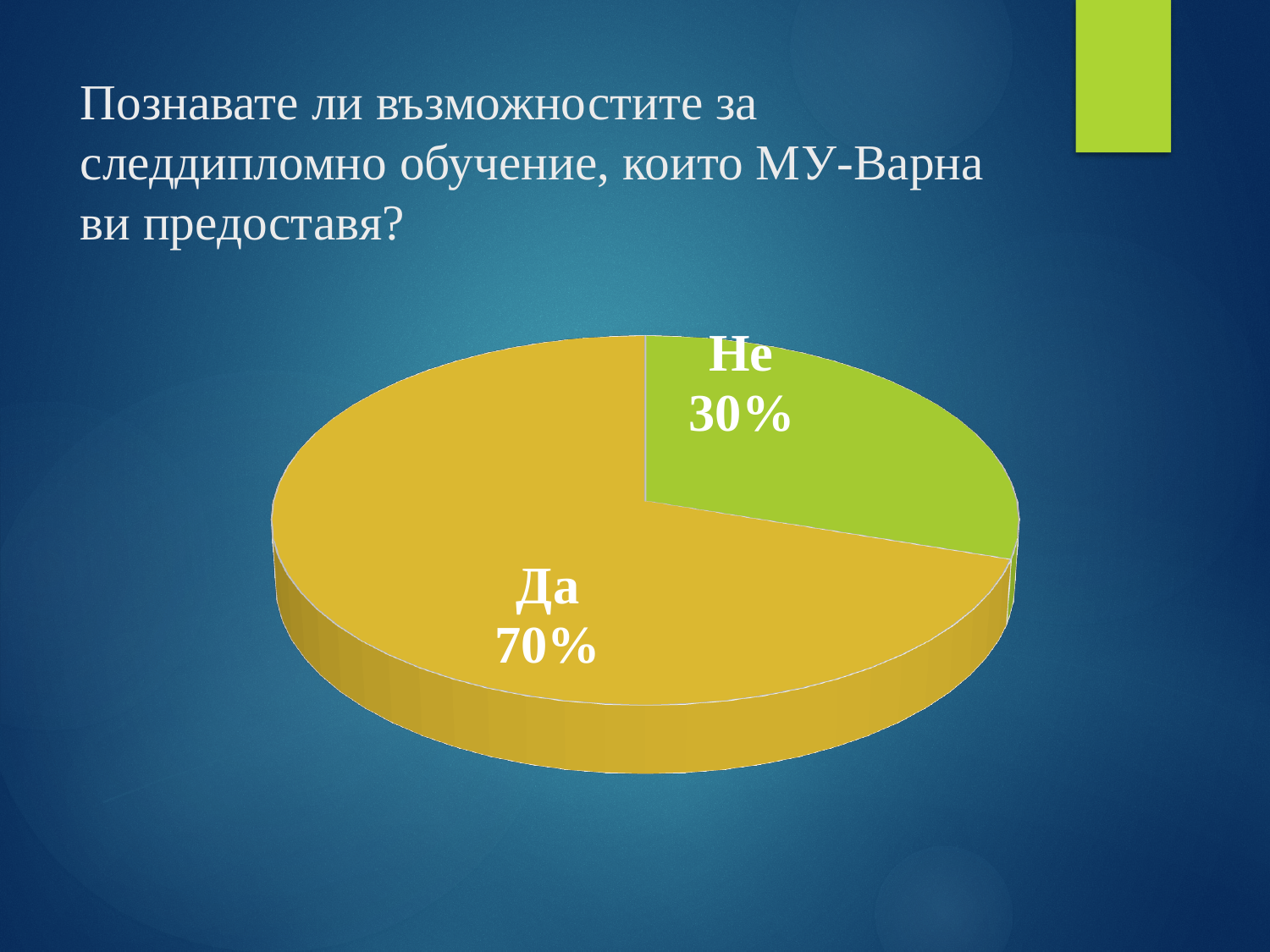
Which slice of the pie is the smallest? Не How many slices does the pie chart have? 2 What percentage of respondents answered "Не"? 30% What kind of chart is shown on the slide? pie chart What is the difference in percentage points between the "Да" and "Не" slices? 40 What colour is the "Не" slice? green Which is larger, the "Да" slice or the "Не" slice? Да Which slice of the pie is the largest? Да What percentage of respondents answered "Да"? 70% What colour is the "Да" slice? yellow What share of the pie does the "Не" slice represent? 30%